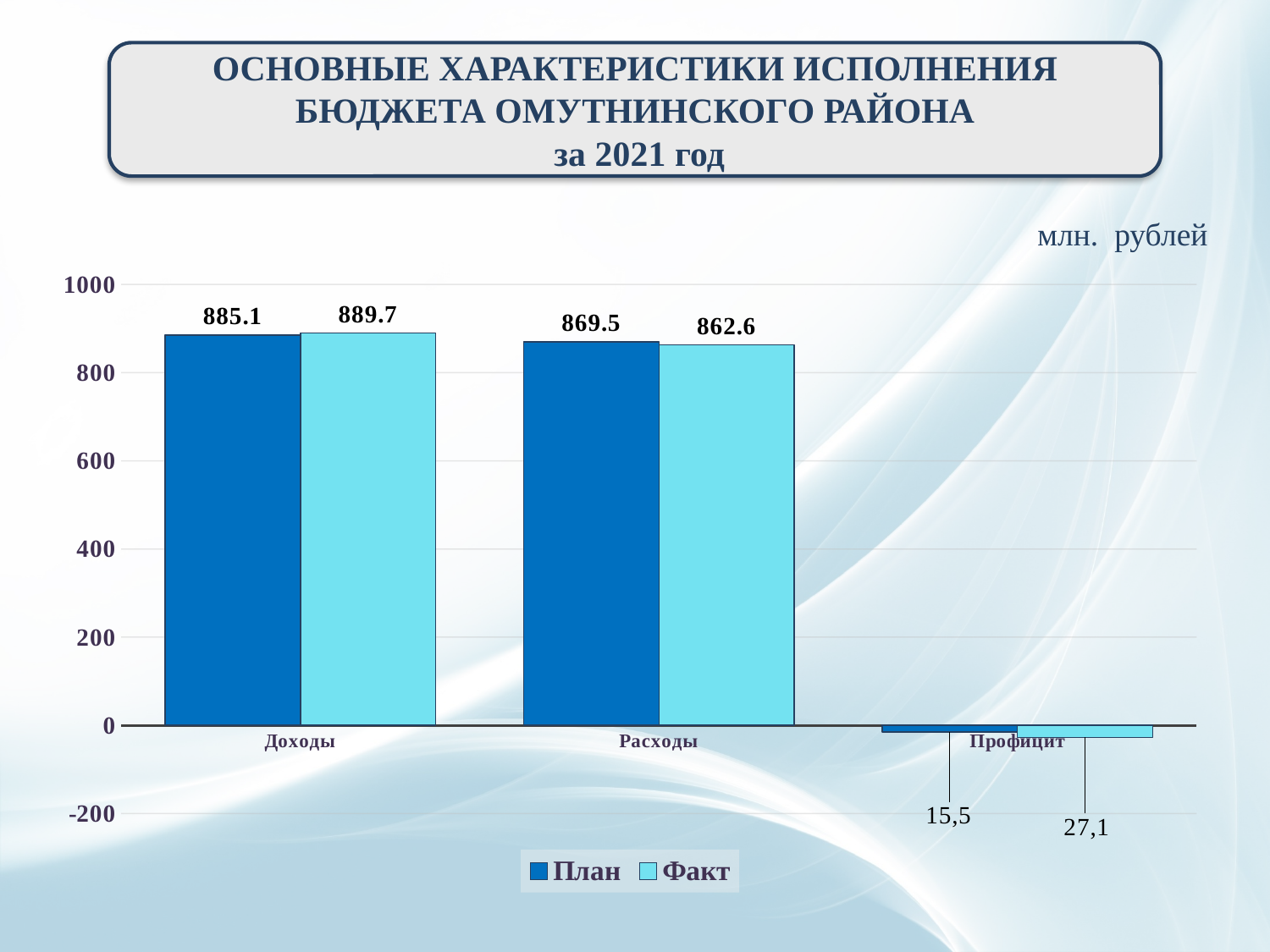
What is the План value for Доходы? 885.1 How many series does the legend list? 2 What is the Факт value for Доходы? 889.7 Which category has the lowest values in the chart? Профицит What value is printed for Факт under Профицит? 27,1 What is the difference between the План and Факт values for Расходы? 6.9 What is the План value for Расходы? 869.5 What kind of chart is shown on the slide? Bar chart What is the difference between the Факт and План values for Доходы? 4.6 How many categories are shown on the x axis? 3 Which is larger for Расходы, the План value or the Факт value? План What is the Факт value for Расходы? 862.6